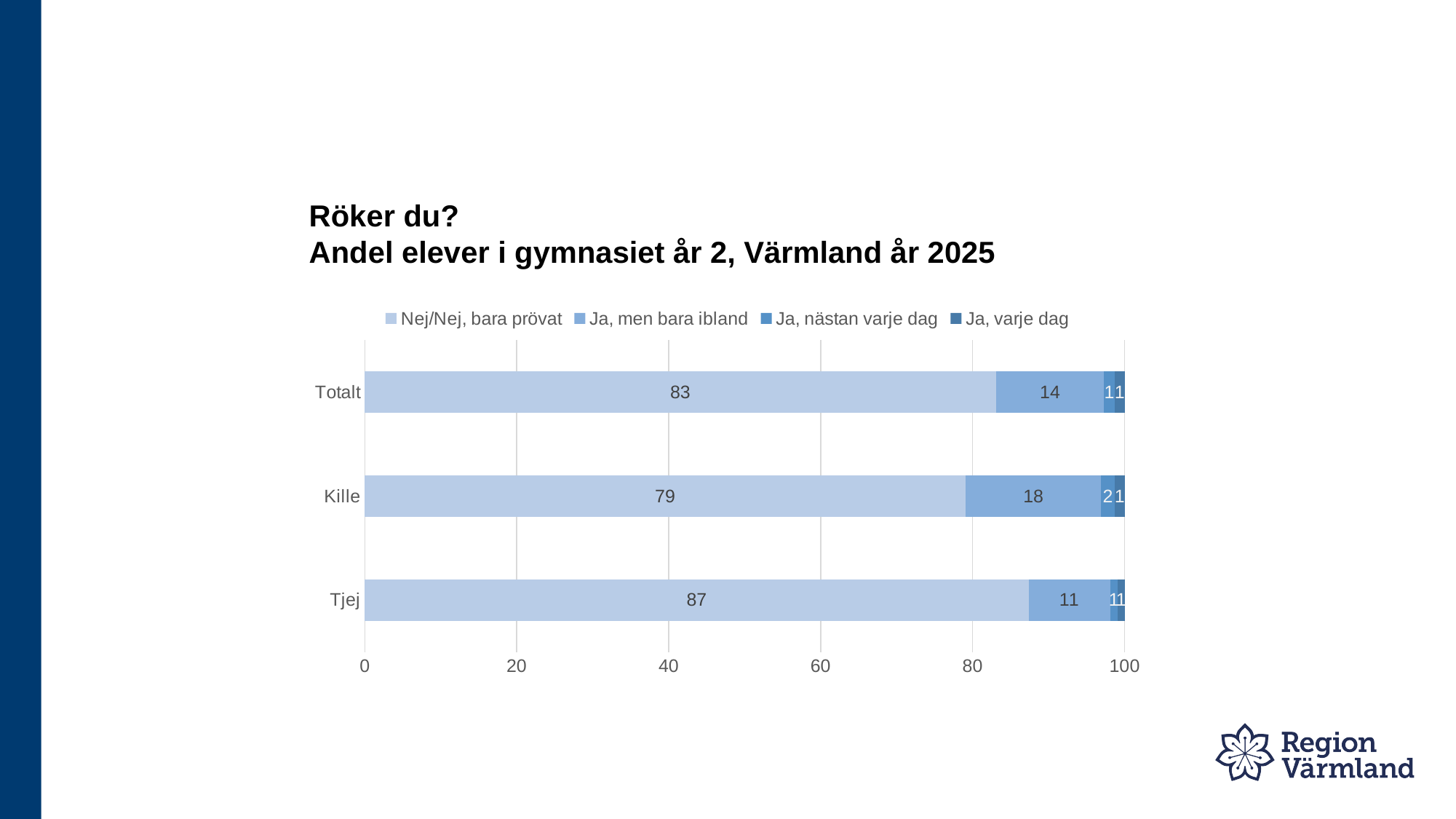
What is the value for "Ja, men bara ibland" for Tjej? 11 Which category has the highest value for "Nej/Nej, bara prövat"? Tjej What is the difference between the "Nej/Nej, bara prövat" values for Tjej and Kille? 8 Which category has the lowest value for "Ja, men bara ibland"? Tjej How many series does the legend list? 4 How many categories are shown on the y axis? 3 Which is larger: the "Ja, men bara ibland" value for Kille or for Totalt? Kille What is the value for "Nej/Nej, bara prövat" for Totalt? 83 What is the value for "Ja, nästan varje dag" for Kille? 2 What kind of chart is shown on the slide? Stacked bar chart What is the total of the stacked bar for Kille? 100 What is the value for "Nej/Nej, bara prövat" for Kille? 79